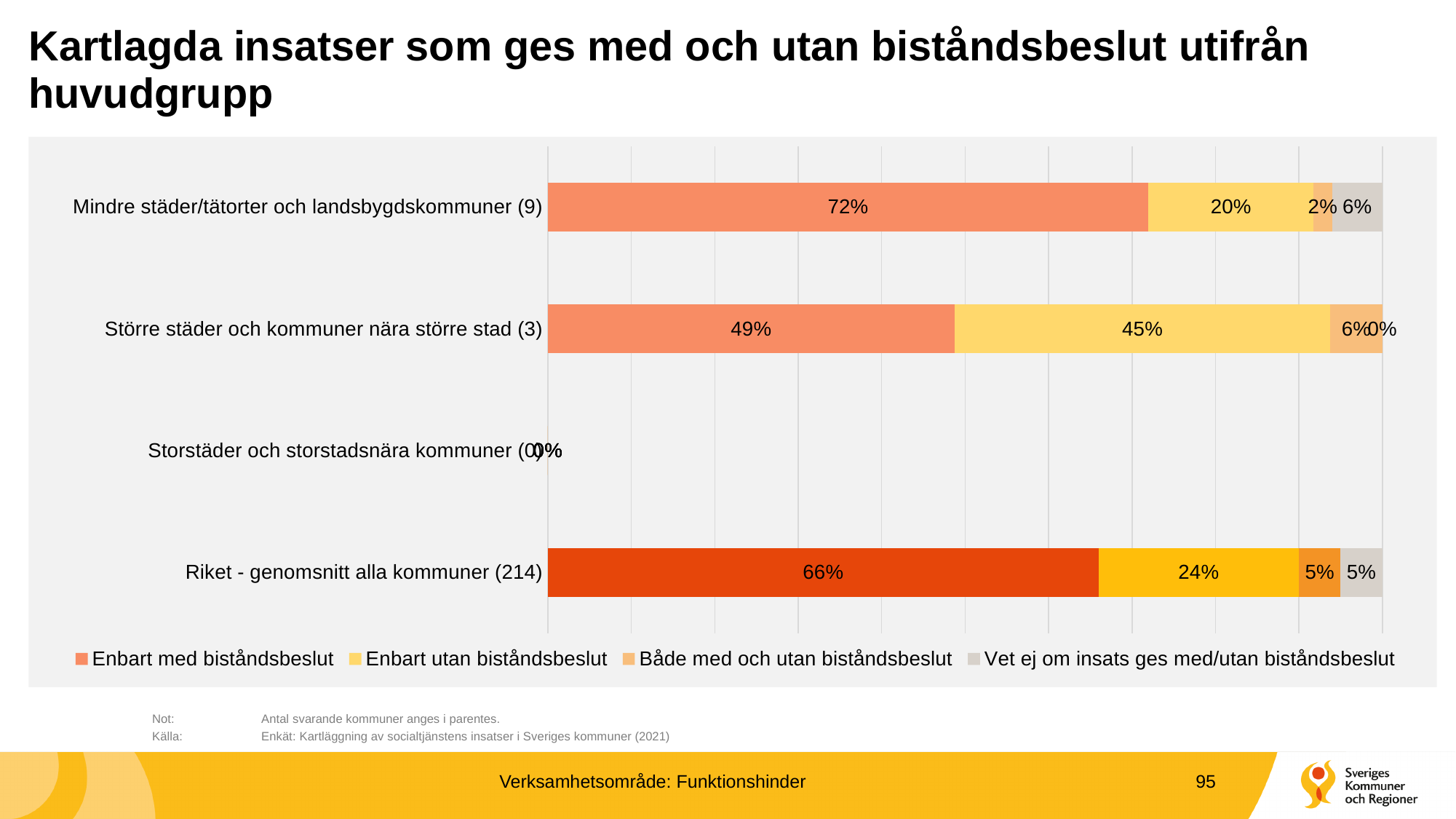
Which is larger: the "Enbart utan biståndsbeslut" value for Riket - genomsnitt alla kommuner (214) or for Mindre städer/tätorter och landsbygdskommuner (9)? Riket - genomsnitt alla kommuner (214) What is the value for "Enbart med biståndsbeslut" for Mindre städer/tätorter och landsbygdskommuner (9)? 72% How many series does the legend list? 4 What is the value for "Både med och utan biståndsbeslut" for Riket - genomsnitt alla kommuner (214)? 5% What is the value for "Enbart med biståndsbeslut" for Riket - genomsnitt alla kommuner (214)? 66% How many categories are shown on the chart? 4 What kind of chart is shown on the slide? Stacked bar chart What is the value for "Enbart utan biståndsbeslut" for Större städer och kommuner nära större stad (3)? 45% Which category has the highest value for "Enbart med biståndsbeslut"? Mindre städer/tätorter och landsbygdskommuner (9) What is the difference between the "Enbart med biståndsbeslut" values for Mindre städer/tätorter och landsbygdskommuner (9) and Riket - genomsnitt alla kommuner (214)? 6% What is the value for "Vet ej om insats ges med/utan biståndsbeslut" for Mindre städer/tätorter och landsbygdskommuner (9)? 6% Which category has the highest value for "Enbart utan biståndsbeslut"? Större städer och kommuner nära större stad (3)